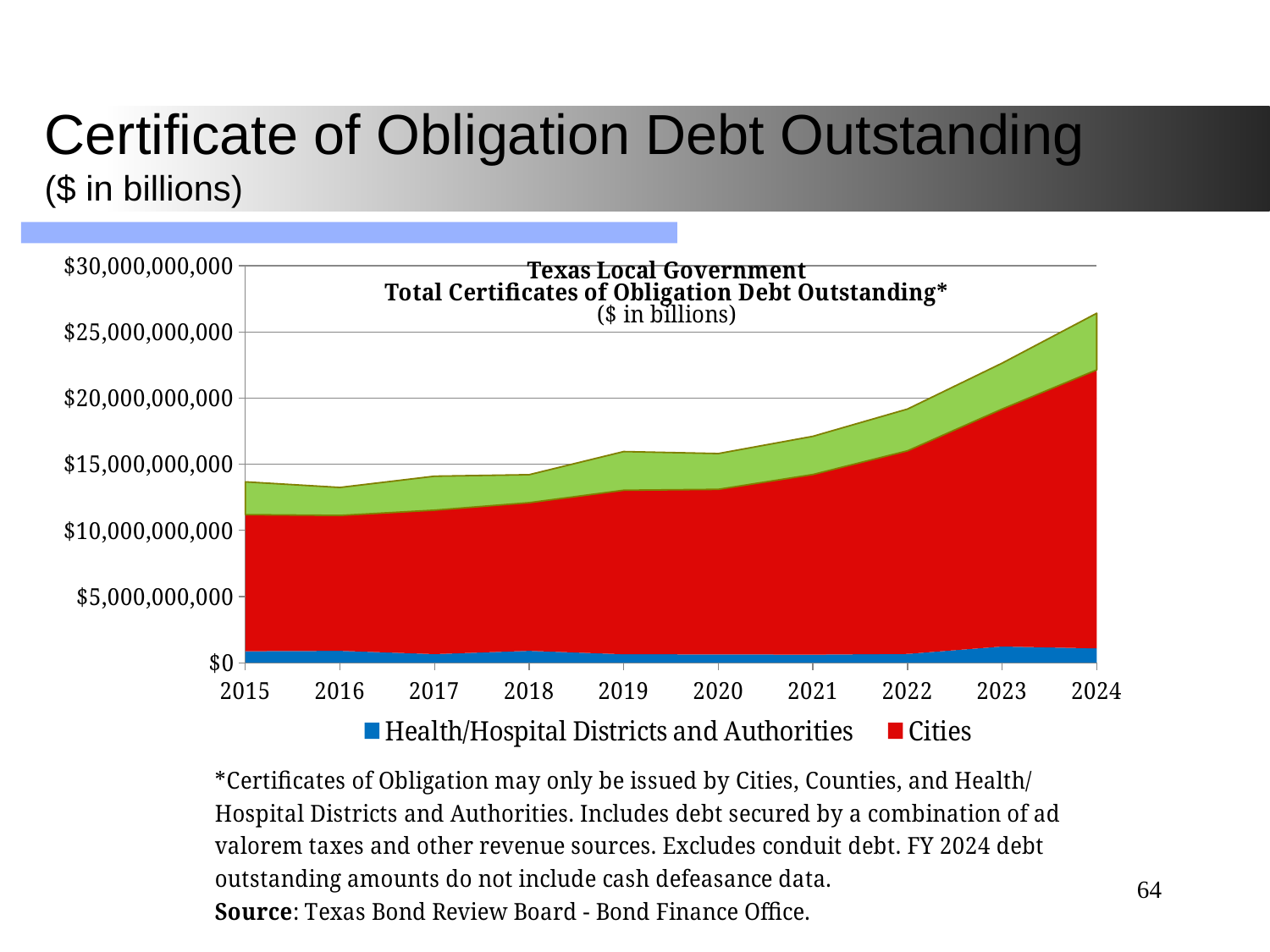
How many series does the chart's legend list? 2 Is the total debt outstanding in 2024 greater or less than $25,000,000,000? greater Is the value for Cities in 2015 greater or less than $10,000,000,000? greater How many years are shown along the x axis of the chart? 10 Does the total debt outstanding generally rise or fall from 2015 to 2024? Rise What kind of chart is shown on the slide? Area chart Is the total debt outstanding in 2015 greater or less than $15,000,000,000? less Which year has the highest total certificates of obligation debt outstanding? 2024 What colour represents Cities in the chart? Red Which is larger, the total debt outstanding in 2024 or in 2015? 2024